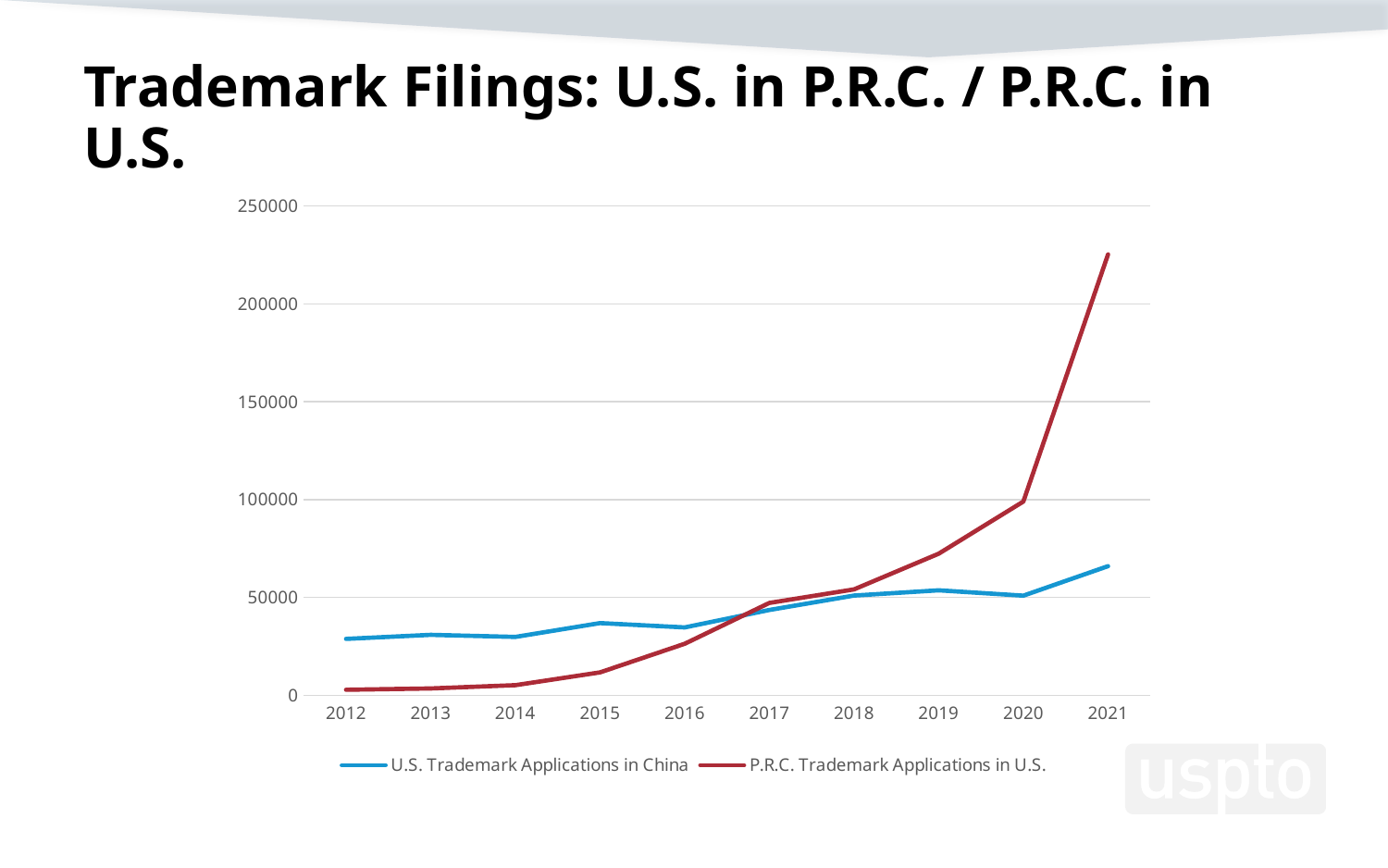
How many series does the legend list? 2 Is the value for P.R.C. Trademark Applications in U.S. in 2021 greater or less than 200000? greater Does the value for P.R.C. Trademark Applications in U.S. rise or fall from 2012 to 2021? rise Is the value for P.R.C. Trademark Applications in U.S. in 2016 greater or less than 50000? less In 2012, which series has the larger value: U.S. Trademark Applications in China or P.R.C. Trademark Applications in U.S.? U.S. Trademark Applications in China In which year is the value for P.R.C. Trademark Applications in U.S. highest? 2021 Is the value for U.S. Trademark Applications in China in 2021 greater or less than 100000? less What kind of chart is shown on the slide? line chart In 2021, which series has the larger value: U.S. Trademark Applications in China or P.R.C. Trademark Applications in U.S.? P.R.C. Trademark Applications in U.S. How many years are shown along the x axis? 10 In which year is the value for U.S. Trademark Applications in China highest? 2021 In which year is the value for P.R.C. Trademark Applications in U.S. lowest? 2012